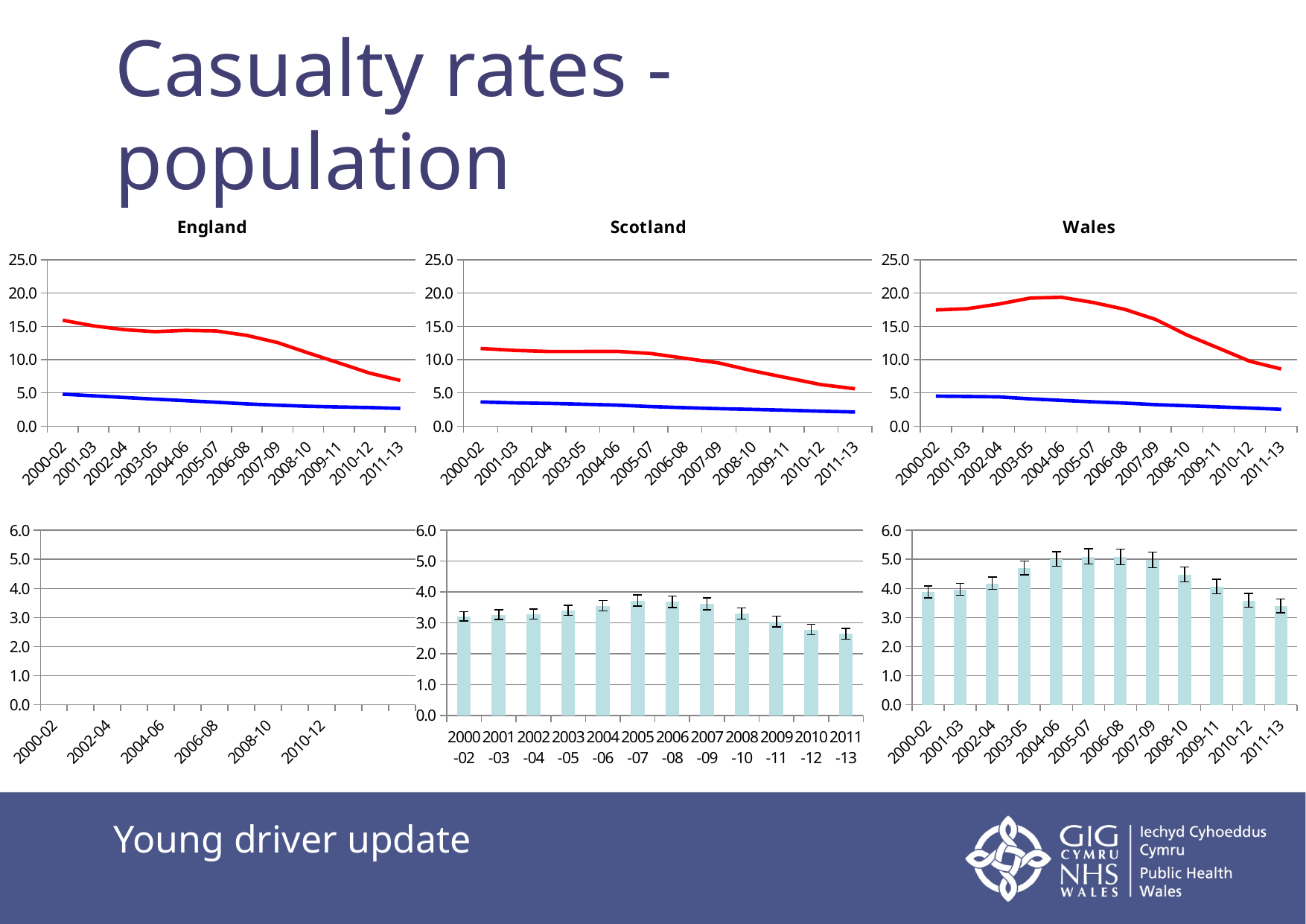
What colours are the two lines in the Wales line chart? red and blue In the Scotland bar chart at the bottom of the slide, how many bars are there? 12 In the Wales bar chart at the bottom of the slide, which is larger, the value for 2005-07 or the value for 2011-13? 2005-07 What type of chart is the Wales chart at the bottom right of the slide? bar chart In the Scotland bar chart at the bottom of the slide, is the value for 2011-13 greater or less than 3.0? less In the England line chart, how many time periods are shown on the x axis? 12 In the Wales line chart, is the value of the red line for 2004-06 greater or less than 15.0? greater What type of chart is the England chart at the top left of the slide? line chart In the Scotland line chart, which line is higher throughout, the red line or the blue line? red line In the Scotland line chart, is the value of the red line for 2000-02 greater or less than 10.0? greater In the England line chart, does the red line rise or fall from 2000-02 to 2011-13? fall